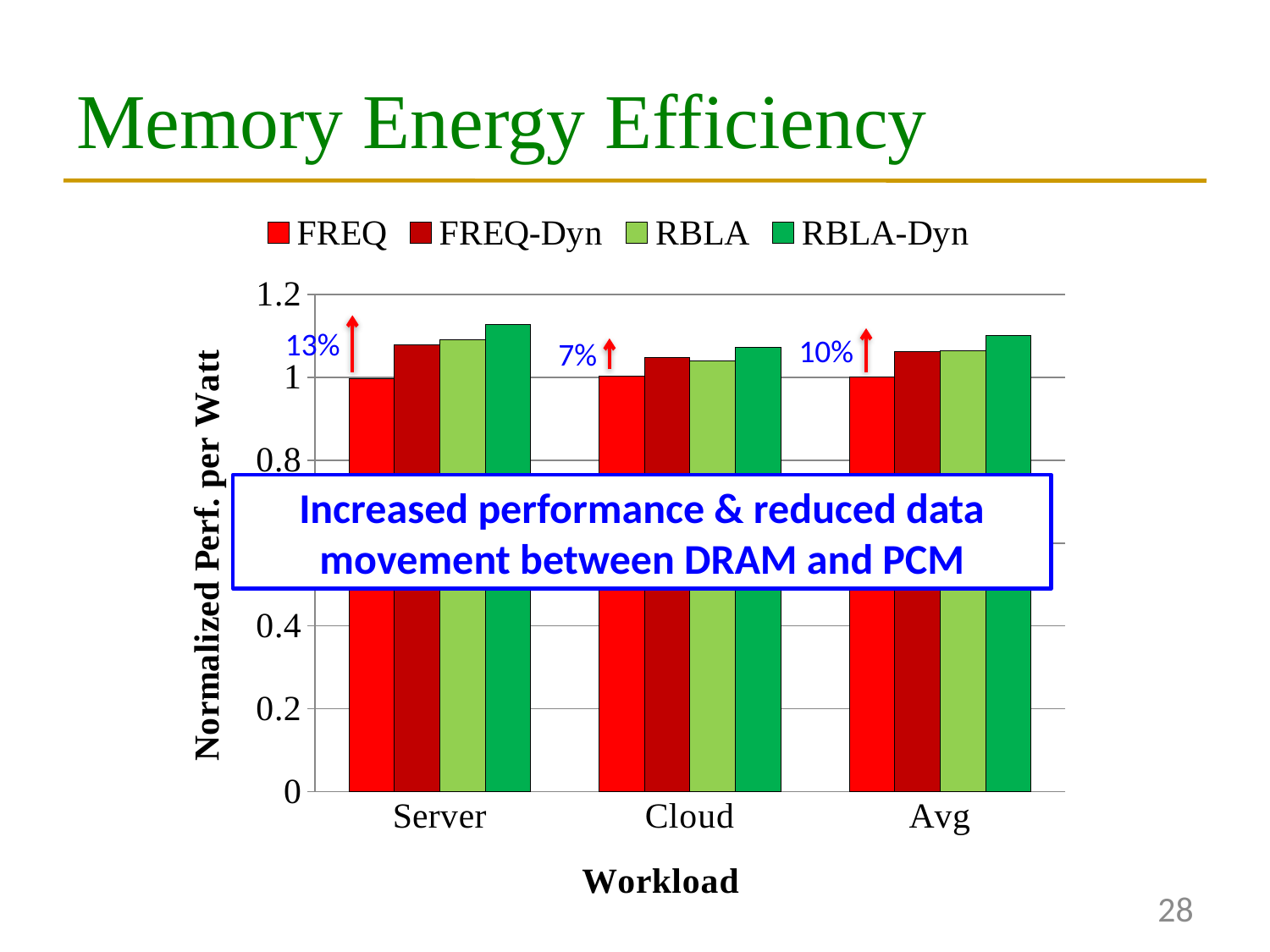
Which is larger: the RBLA-Dyn bar for Server or the RBLA-Dyn bar for Cloud? Server Which series has the lowest bar for the Cloud workload? FREQ Is the value for RBLA-Dyn on the Avg workload greater or less than 1.2? less How many workload categories are shown on the x axis? 3 Is the value for RBLA-Dyn on the Server workload greater or less than 1? greater Which series has the highest bar for the Server workload? RBLA-Dyn Which workload has the highest RBLA-Dyn bar? Server How many series does the legend list? 4 What is the title of the y axis? Normalized Perf. per Watt What kind of chart is shown on the slide? bar chart What percentage improvement is annotated above the Server group? 13%